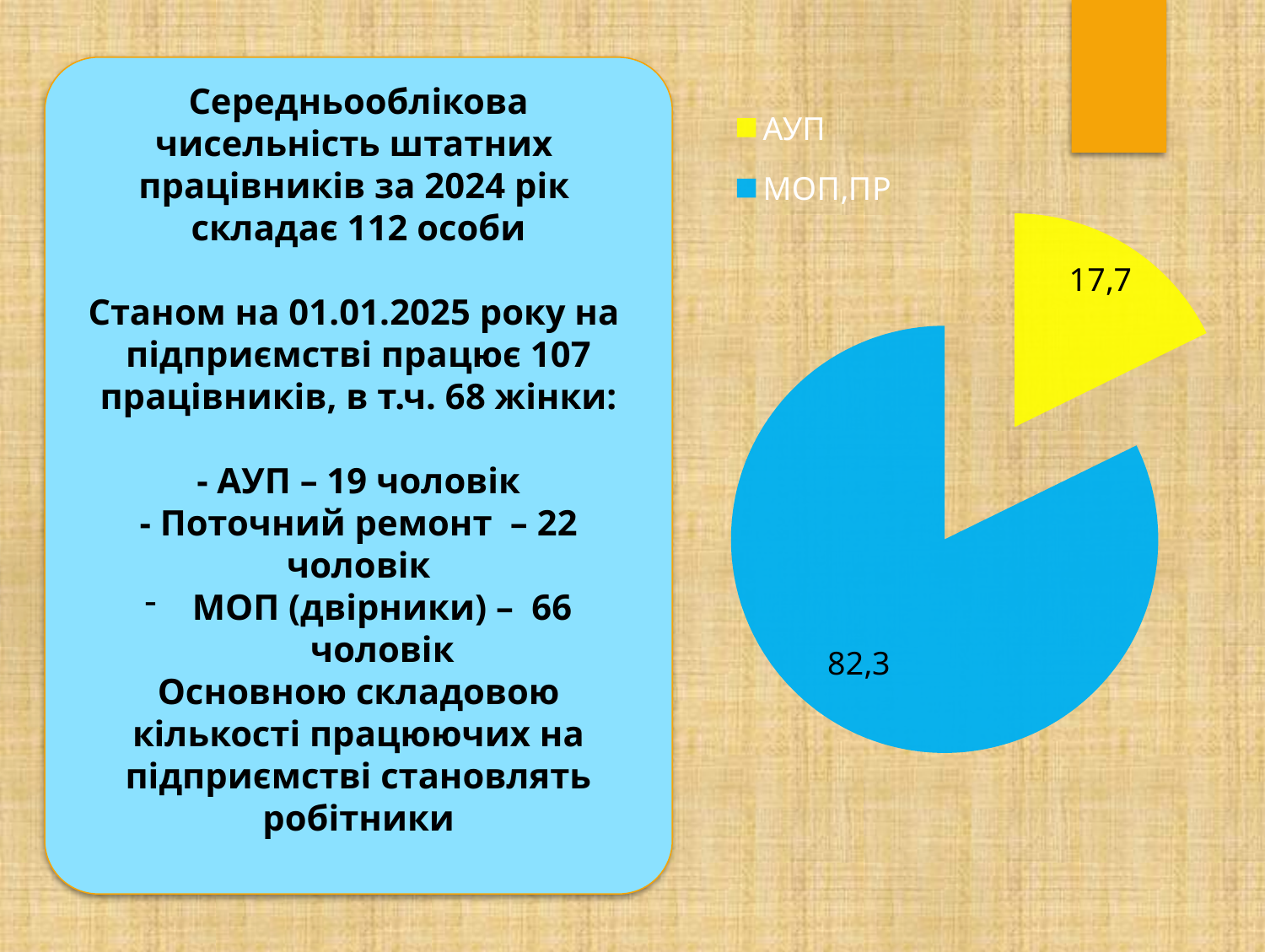
What kind of chart is shown on the slide? pie chart Which is larger in the pie chart, АУП or МОП,ПР? МОП,ПР What is the difference between the МОП,ПР value and the АУП value in the pie chart? 64,6 What colour is the АУП slice in the pie chart? yellow What is the value shown for the АУП slice of the pie chart? 17,7 What colour is the МОП,ПР slice in the pie chart? blue How many entries does the legend of the pie chart list? 2 Which slice of the pie chart is the smallest? АУП Which slice of the pie chart is the largest? МОП,ПР What is the value shown for the МОП,ПР slice of the pie chart? 82,3 How many slices does the pie chart have? 2